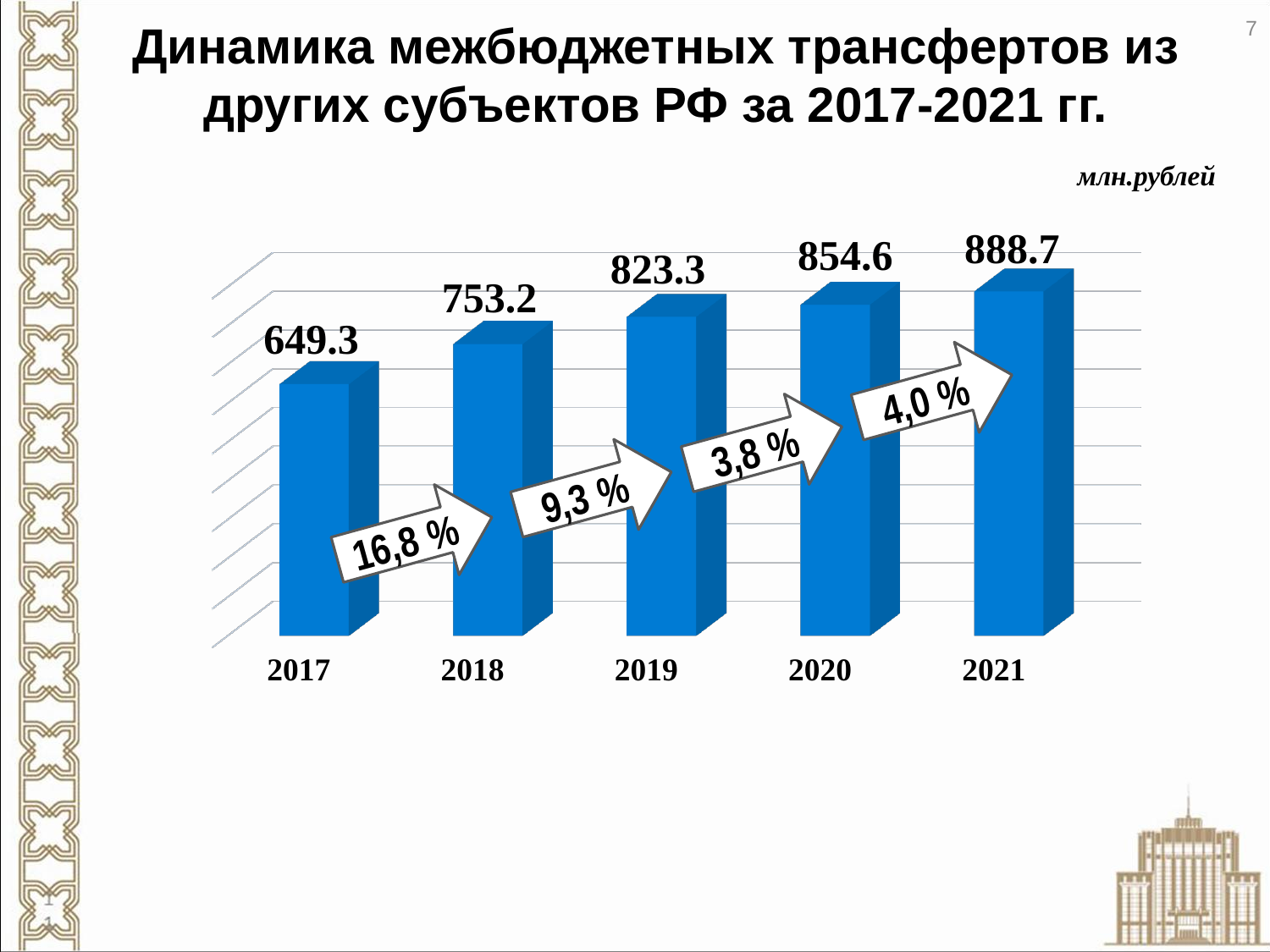
What is the difference between the values for 2018 and 2017? 103.9 Do the values rise or fall from 2017 to 2021? rise What is the value for 2017? 649.3 What is the value for 2019? 823.3 What kind of chart is shown on the slide? bar chart What is the value for 2021? 888.7 What is the difference between the values for 2021 and 2020? 34.1 Which is larger, the value for 2019 or the value for 2020? 2020 Which year has the lowest value? 2017 Which year has the highest value? 2021 What percentage growth is shown on the arrow between 2017 and 2018? 16,8 % How many years are shown on the chart? 5